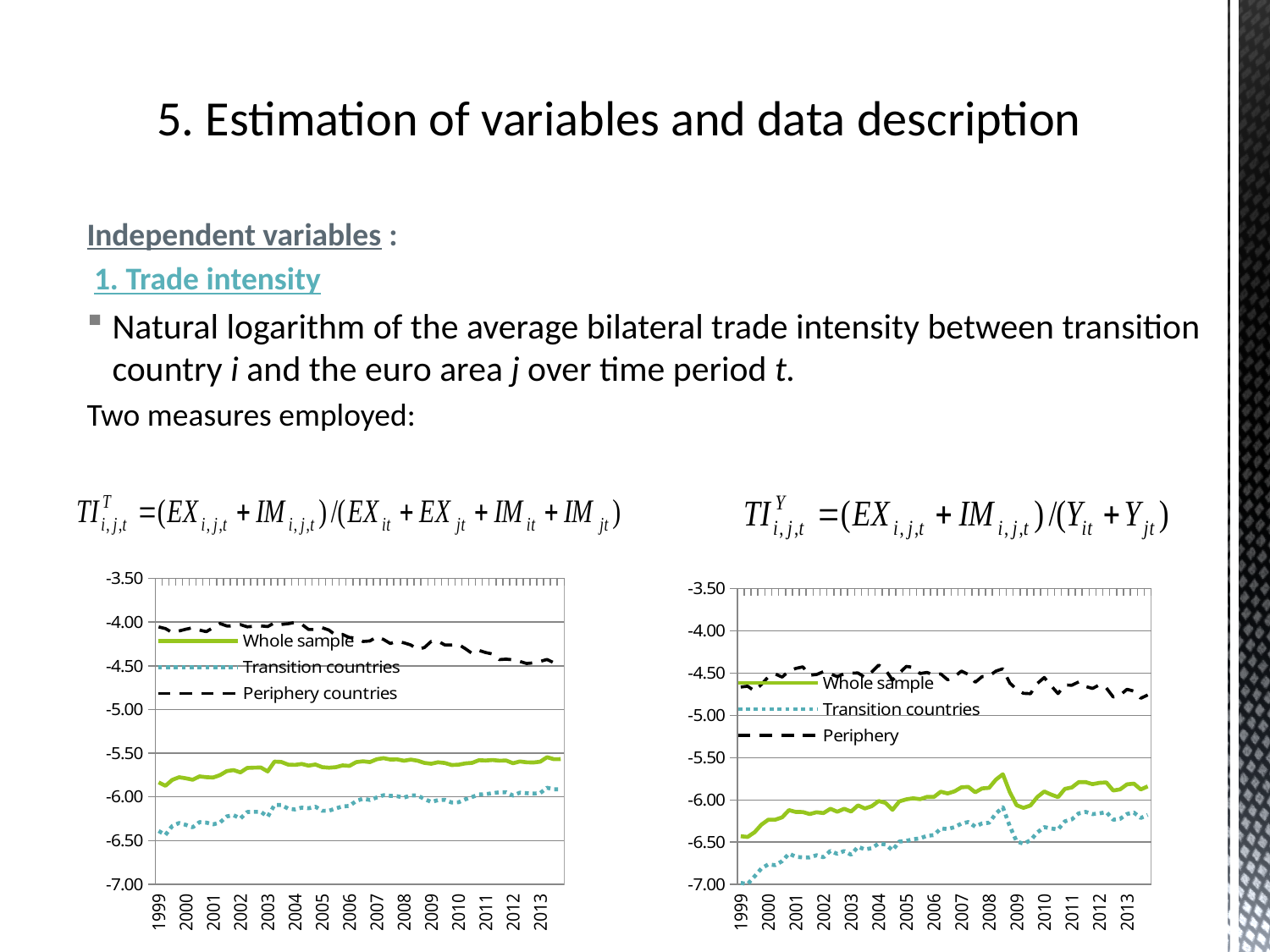
In the right chart, is the value for Periphery in 2013 greater or less than -4.50? less In the left chart, is the value for Periphery countries in 1999 greater or less than -4.50? greater What are the three series listed in the legend of the right chart? Whole sample, Transition countries, Periphery In the left chart, do the values for Periphery countries rise or fall from 1999 to 2013? fall How many year labels are shown on the x axis of the right chart? 15 In the right chart, is the value for Whole sample in 2013 greater or less than -6.00? greater In the left chart, which series has the lowest values throughout the period? Transition countries In the left chart, do the values for Transition countries rise or fall from 1999 to 2013? rise What kind of chart is the left chart on the slide? line chart How many series does the legend of the left chart list? 3 In the left chart, which series has the highest values throughout the period? Periphery countries